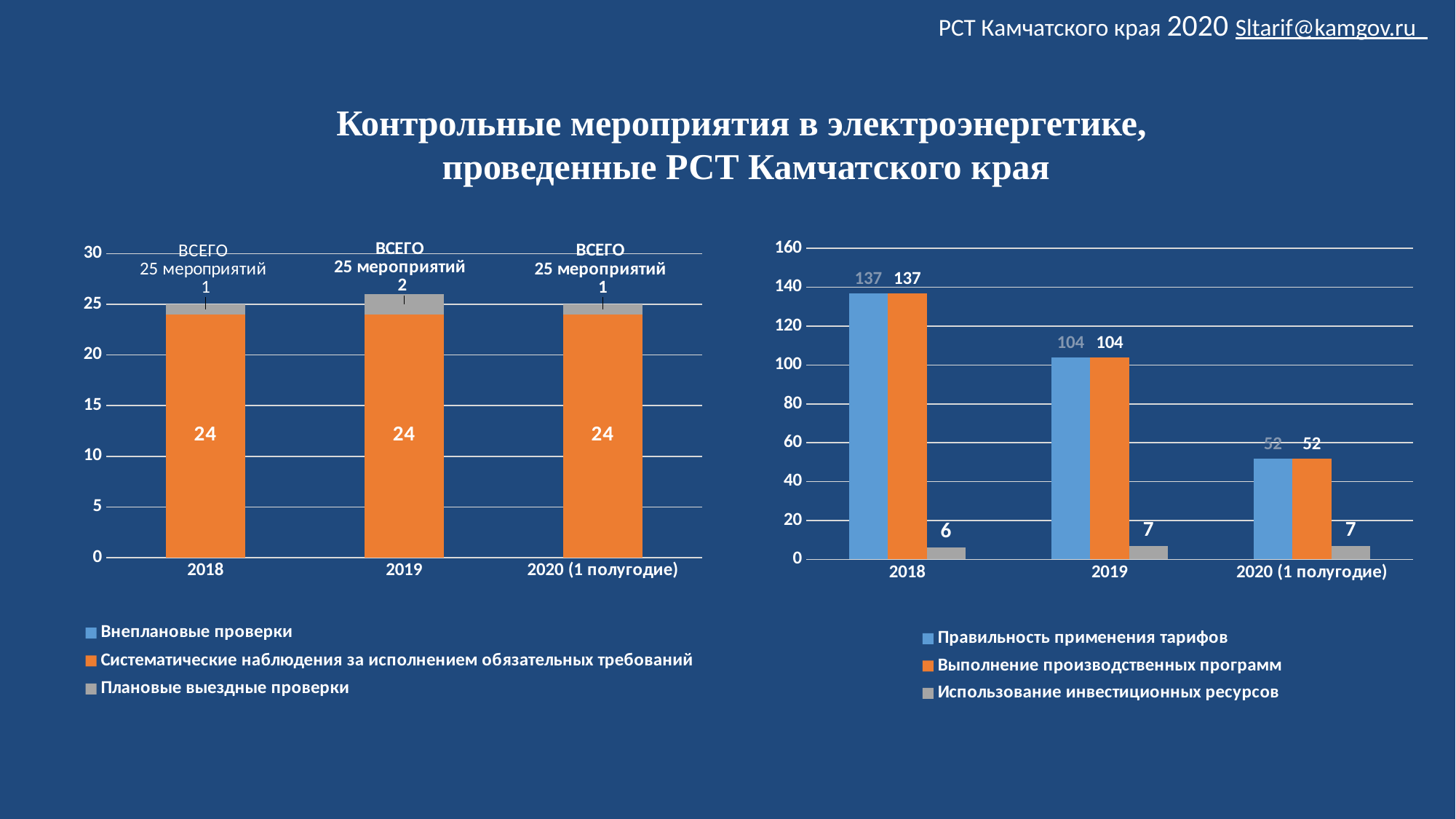
On the left chart, what is the value of Систематические наблюдения за исполнением обязательных требований for 2019? 24 What type of chart is the right chart? bar chart On the left chart, what is the total of the stacked bar for 2018? 25 On the right chart, what is the value of Правильность применения тарифов for 2018? 137 On the right chart, which year has the lowest value for Использование инвестиционных ресурсов? 2018 On the left chart, how many series does the legend list? 3 On the right chart, what is the difference between Правильность применения тарифов in 2018 and in 2019? 33 On the right chart, what is the value of Использование инвестиционных ресурсов for 2019? 7 On the right chart, which year has the highest value for Выполнение производственных программ? 2018 On the right chart, do the values for Выполнение производственных программ rise or fall from 2018 to 2020 (1 полугодие)? fall On the right chart, how many categories are shown on the x axis? 3 On the left chart, what is the value of Плановые выездные проверки for 2019? 2